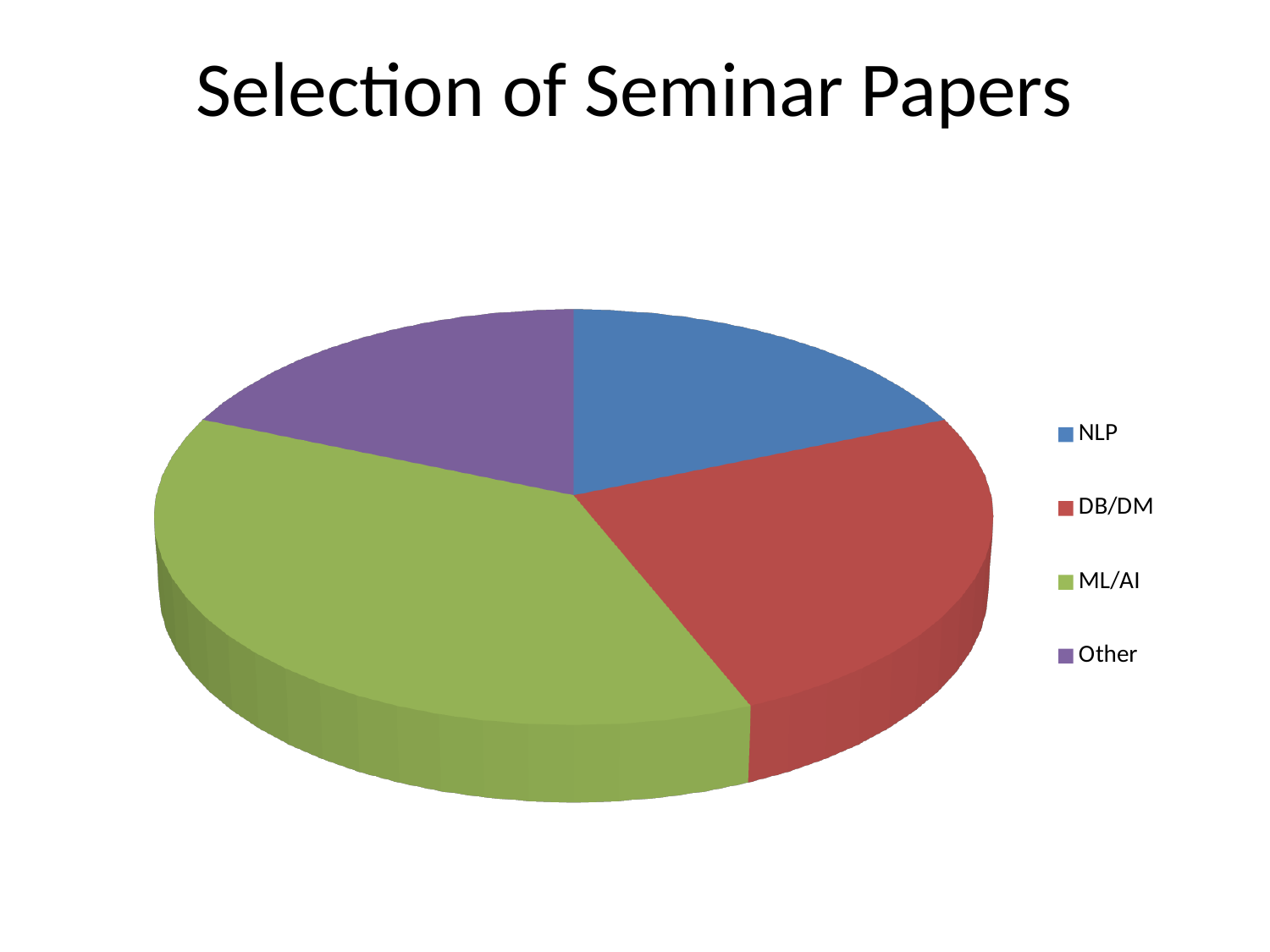
What is the title of the chart? Selection of Seminar Papers Which category is shown in purple? Other Which slice is larger, DB/DM or NLP? DB/DM What kind of chart is shown on the slide? pie chart Which category has the largest slice of the pie? ML/AI Which slice is larger, ML/AI or NLP? ML/AI How many categories does the pie chart show? 4 Which slice is larger, ML/AI or DB/DM? ML/AI Which colour represents ML/AI in the legend? green